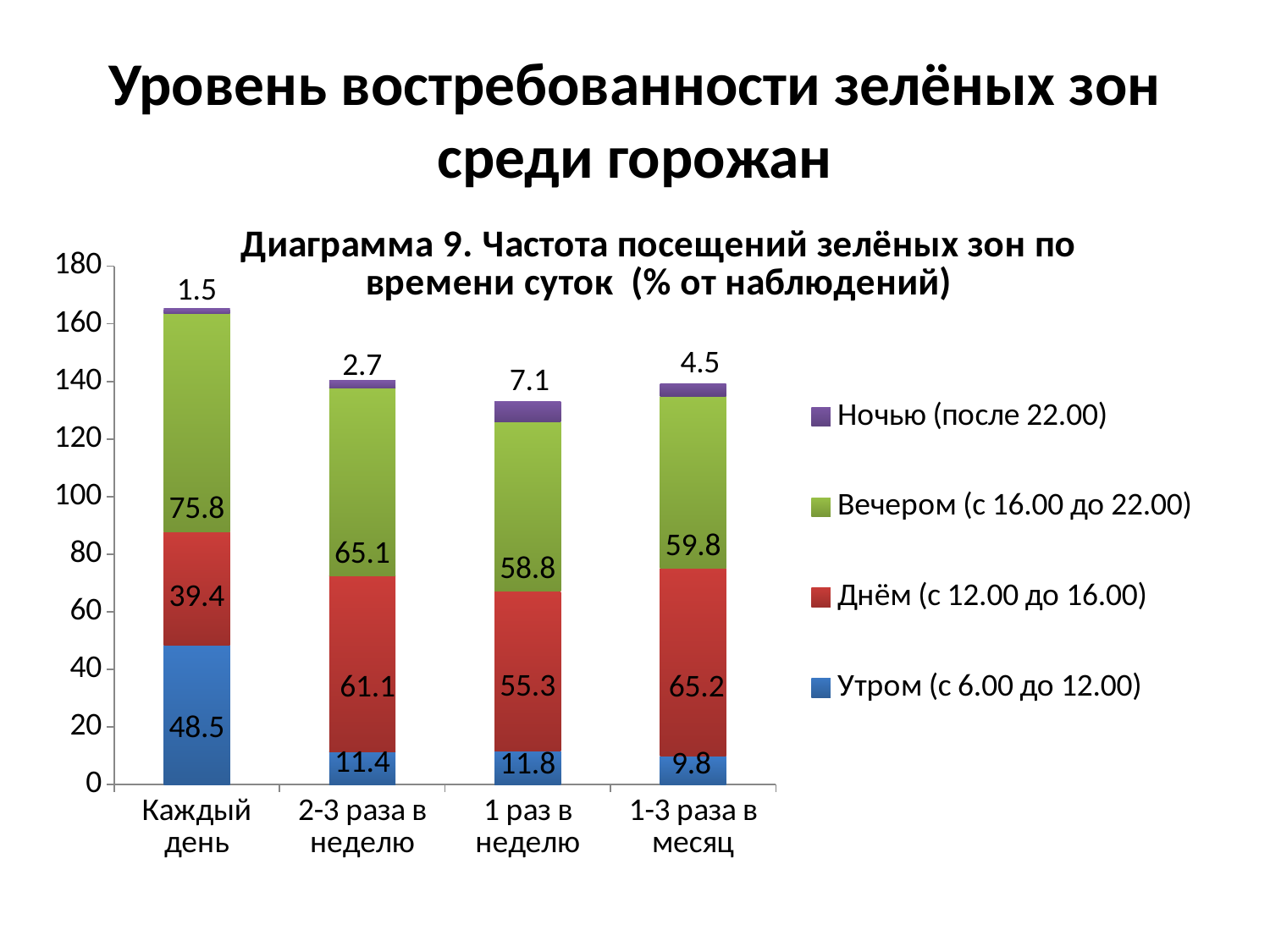
What is the value for Днём (с 12.00 до 16.00) in the 1-3 раза в месяц category? 65.2 What kind of chart is shown on the slide? Stacked bar chart Which series is shown in green? Вечером (с 16.00 до 22.00) What is the difference between the Вечером (с 16.00 до 22.00) values for Каждый день and 2-3 раза в неделю? 10.7 What is the value for Утром (с 6.00 до 12.00) in the Каждый день category? 48.5 Which is larger: the Днём (с 12.00 до 16.00) value for 2-3 раза в неделю or for 1 раз в неделю? 2-3 раза в неделю What is the value for Ночью (после 22.00) in the 1 раз в неделю category? 7.1 How many categories are shown on the x axis? 4 What is the total of the stacked bar for Каждый день? 165.2 Which category has the lowest value for Утром (с 6.00 до 12.00)? 1-3 раза в месяц How many series does the legend list? 4 Which category has the highest value for Вечером (с 16.00 до 22.00)? Каждый день